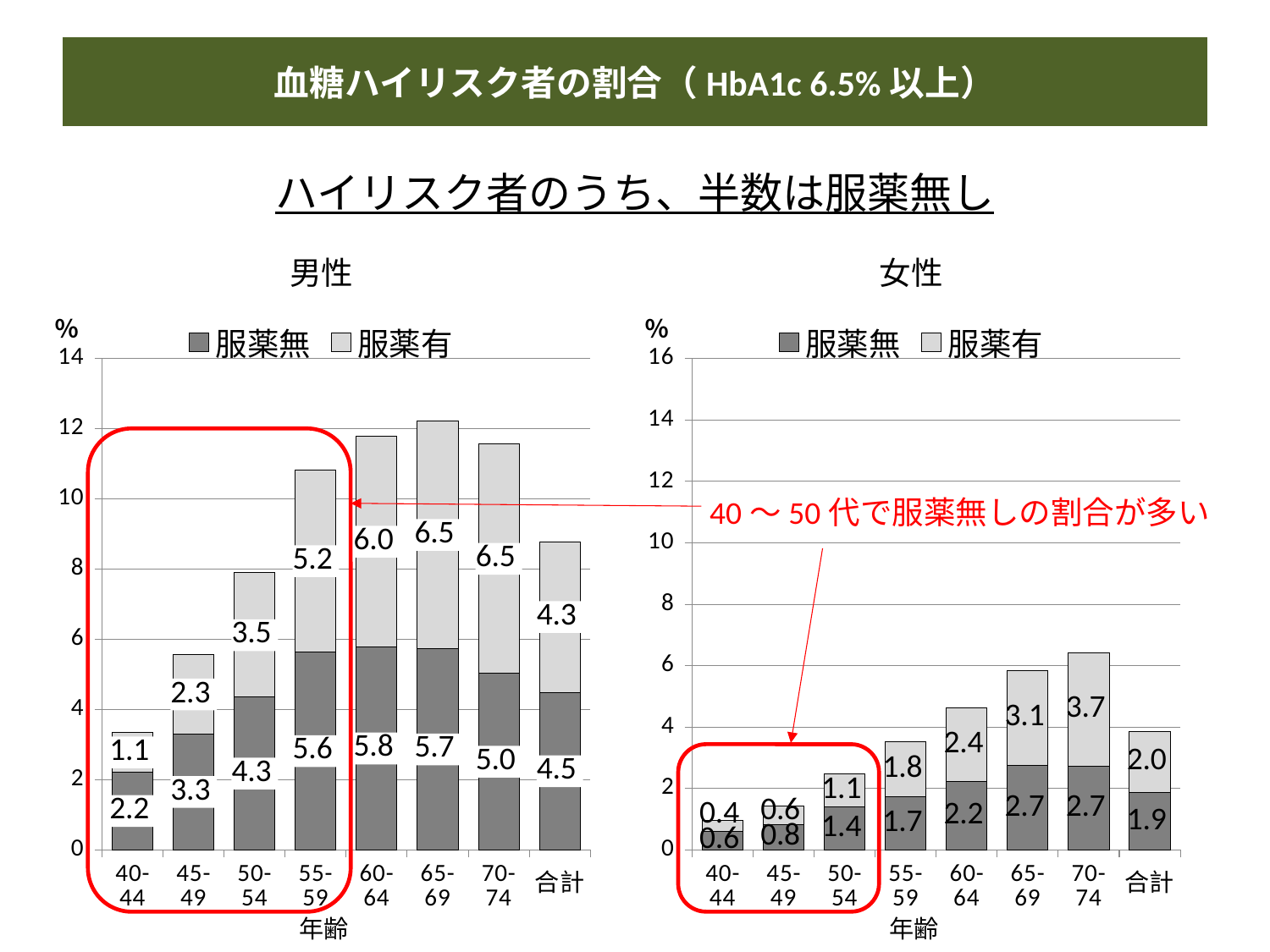
In the 女性 chart, what is the total of the stacked bar for the 70-74 age group? 6.4 In the 男性 chart, what is the total of the stacked bar for the 55-59 age group? 10.8 In the 女性 chart, which age group has the lowest 服薬有 value? 40-44 In the 女性 chart, which is larger for the 65-69 age group, 服薬無 or 服薬有? 服薬有 What type of chart is the 男性 chart? Stacked bar chart In the 女性 chart, what is the 服薬無 value for the 60-64 age group? 2.2 In the 男性 chart, what is the difference between the 服薬有 values for 50-54 and 45-49? 1.2 How many series does the legend of the 女性 chart list? 2 In the 男性 chart, what is the 服薬無 value for the 50-54 age group? 4.3 In the 男性 chart, which age group has the highest 服薬無 value? 60-64 In the 女性 chart, what is the 服薬有 value for 合計? 2.0 In the 男性 chart, what is the 服薬有 value for the 65-69 age group? 6.5